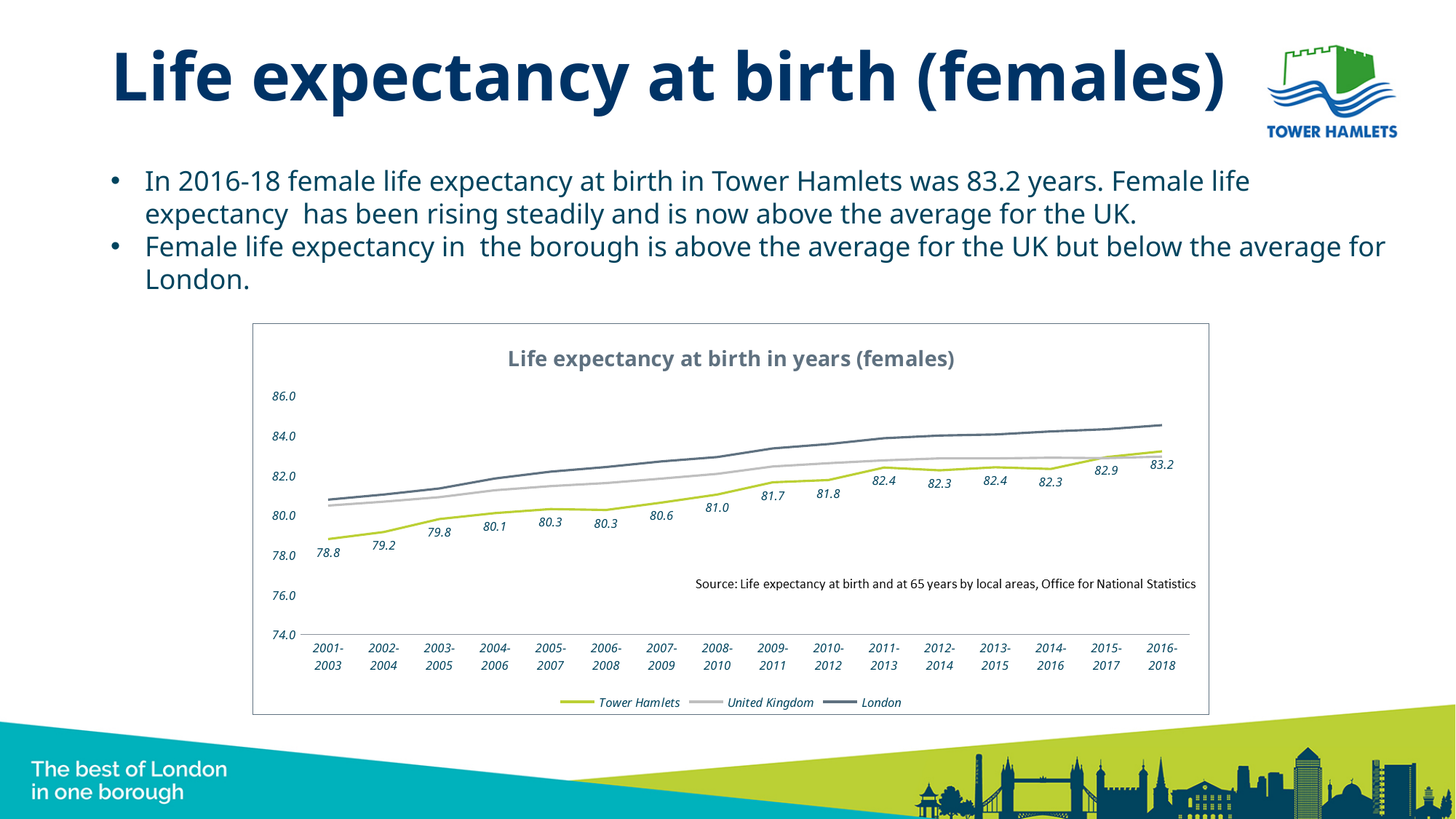
By how much did the Tower Hamlets value increase from 2001-2003 to 2016-2018? 4.4 In which period is the Tower Hamlets value lowest? 2001-2003 How many series does the legend list? 3 What is the Tower Hamlets value for 2001-2003? 78.8 In which period is the Tower Hamlets value highest? 2016-2018 What is the Tower Hamlets female life expectancy at birth for 2016-2018? 83.2 What is the Tower Hamlets value for 2009-2011? 81.7 Does the Tower Hamlets line generally rise or fall from 2001-2003 to 2016-2018? rise Which is larger for Tower Hamlets: the value for 2011-2013 or the value for 2012-2014? 2011-2013 What type of chart is shown on the slide? line chart How many time periods are shown on the x axis? 16 Is the London value for 2016-2018 greater or less than 84.0? greater